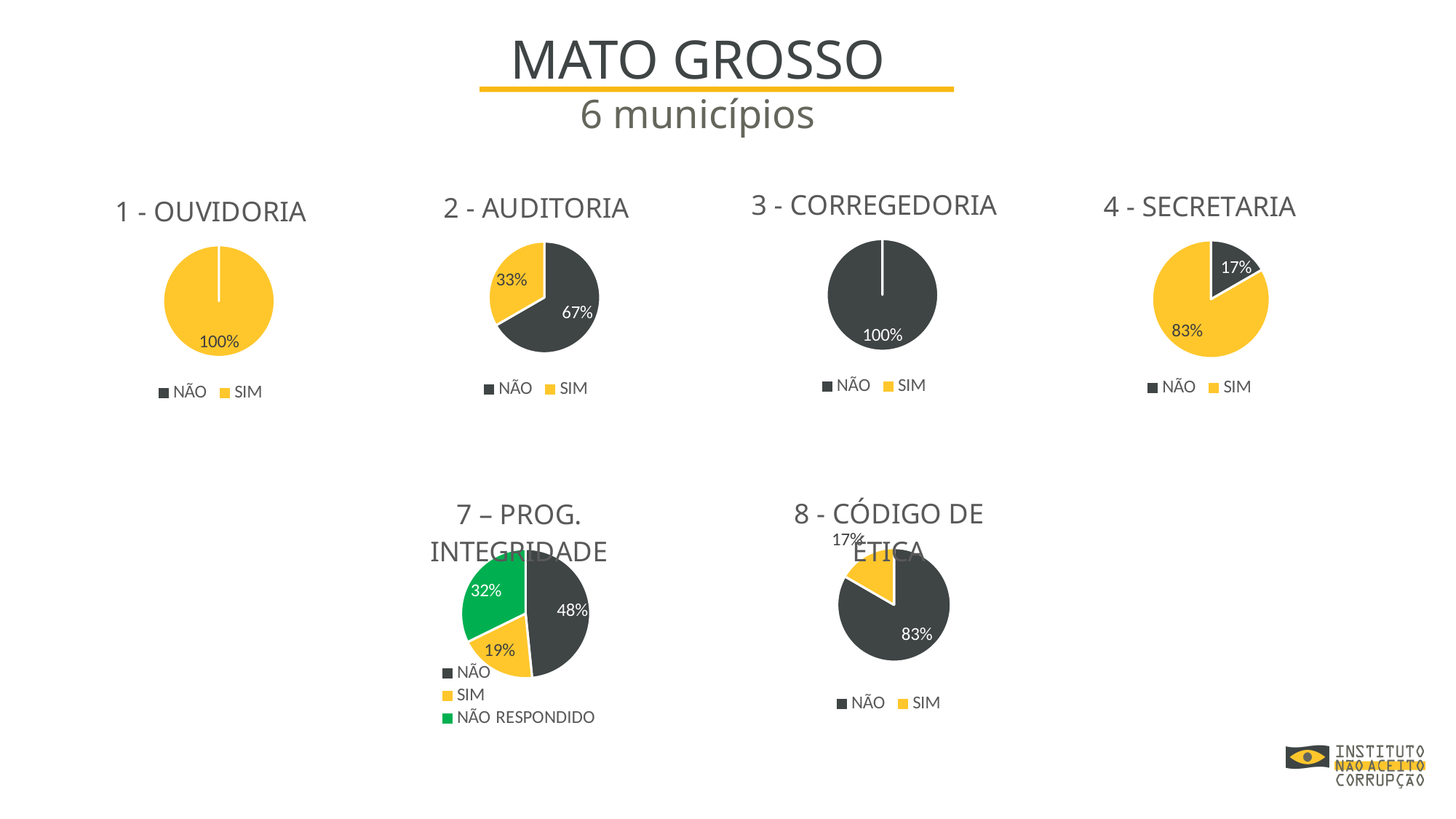
In the '2 - AUDITORIA' pie chart, what share is labelled for SIM? 33% In the '7 – PROG. INTEGRIDADE' pie chart, which category has the smallest slice? SIM In the '4 - SECRETARIA' pie chart, what share is labelled for SIM? 83% How many entries does the legend of the '7 – PROG. INTEGRIDADE' chart list? 3 In the '1 - OUVIDORIA' pie chart, what share is labelled for SIM? 100% What type of chart is used for '3 - CORREGEDORIA'? Pie chart In the '4 - SECRETARIA' pie chart, which is larger, NÃO or SIM? SIM In the '2 - AUDITORIA' pie chart, what is the difference in percentage points between NÃO and SIM? 34 In the '7 – PROG. INTEGRIDADE' pie chart, which category has the largest slice? NÃO